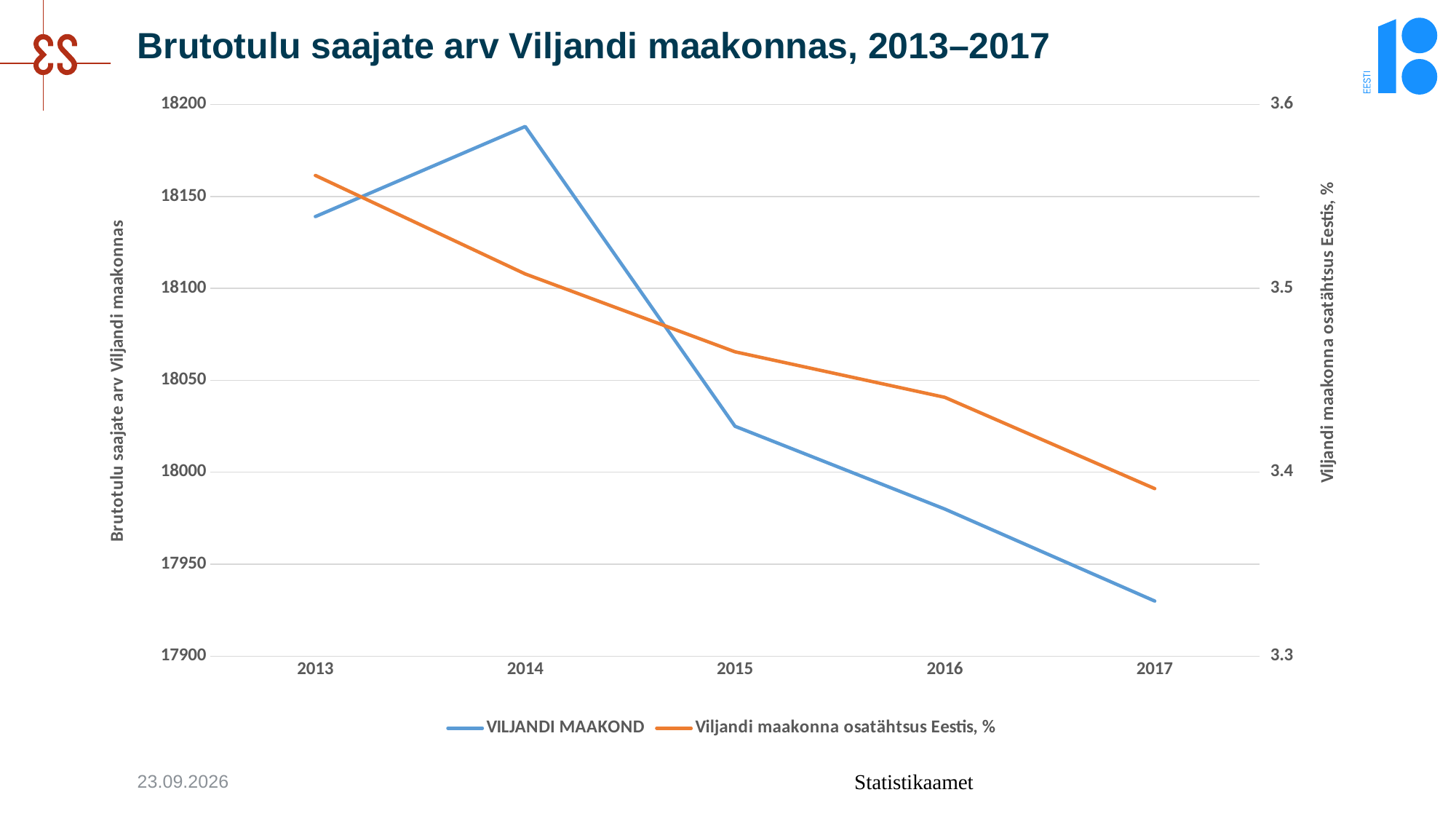
In which year is the 'Viljandi maakonna osatähtsus Eestis, %' series at its highest? 2013 Is the VILJANDI MAAKOND value for 2017 greater or less than 17950? less What is the title of the chart? Brutotulu saajate arv Viljandi maakonnas, 2013–2017 How many years are plotted along the x axis? 5 Is the 'Viljandi maakonna osatähtsus Eestis, %' value for 2017 greater or less than 3.4? less What kind of chart is shown on the slide? line chart How many series does the legend list? 2 Is the VILJANDI MAAKOND value for 2014 greater or less than 18150? greater In which year is the VILJANDI MAAKOND series at its lowest? 2017 Does the 'Viljandi maakonna osatähtsus Eestis, %' series rise or fall from 2013 to 2017? fall In which year is the VILJANDI MAAKOND series at its highest? 2014